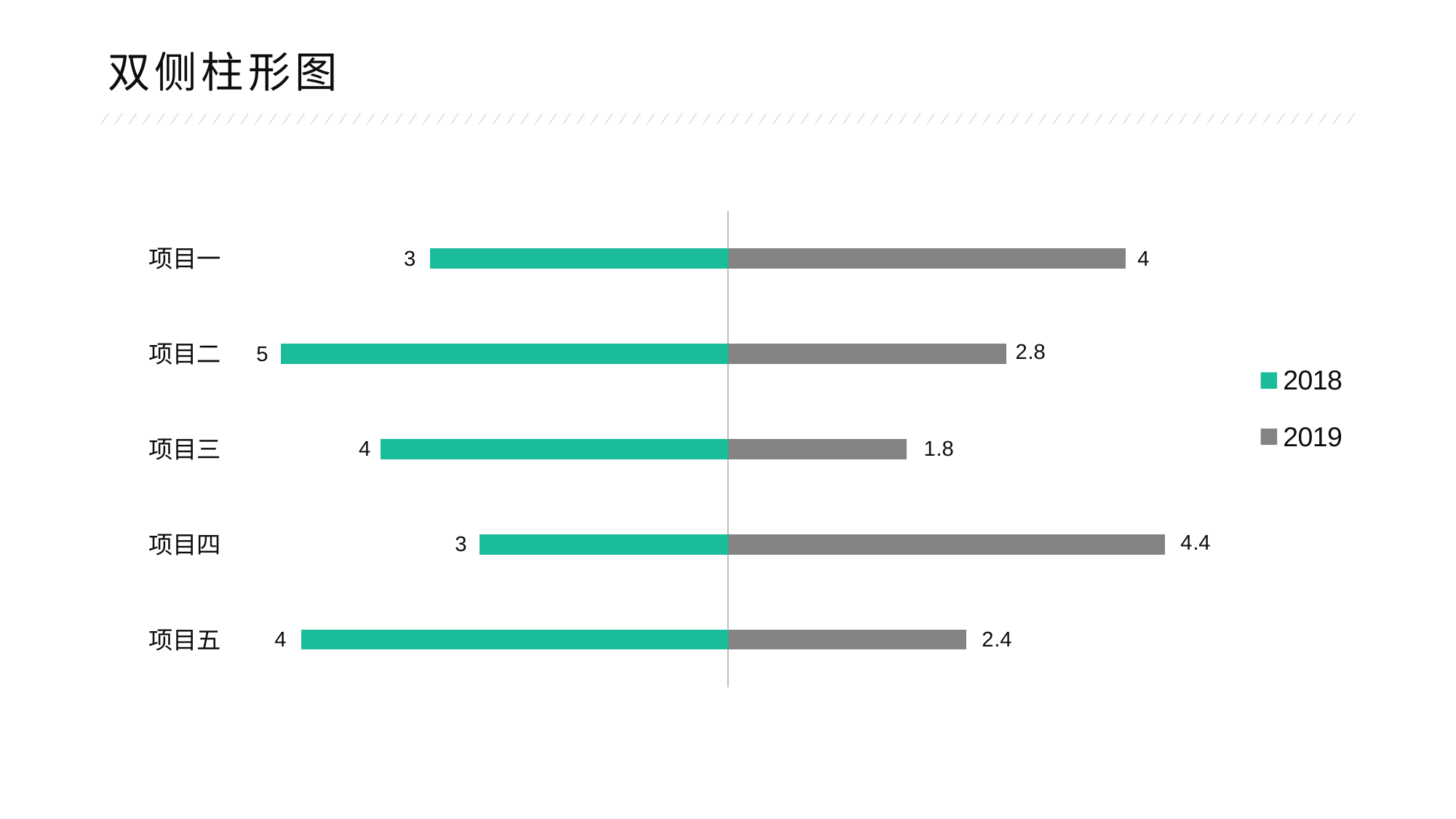
What is the difference between the 2019 and 2018 values for 项目四? 1.4 What is the 2019 value for 项目四? 4.4 What is the 2018 value for 项目五? 4 Which category has the highest 2018 value? 项目二 Which category has the highest 2019 value? 项目四 Which category has the lowest 2019 value? 项目三 What is the 2019 value for 项目三? 1.8 How many series does the legend list? 2 For 项目二, which series has the larger value, 2018 or 2019? 2018 How many categories are shown in the chart? 5 What kind of chart is shown on the slide? bar chart What is the 2018 value for 项目二? 5